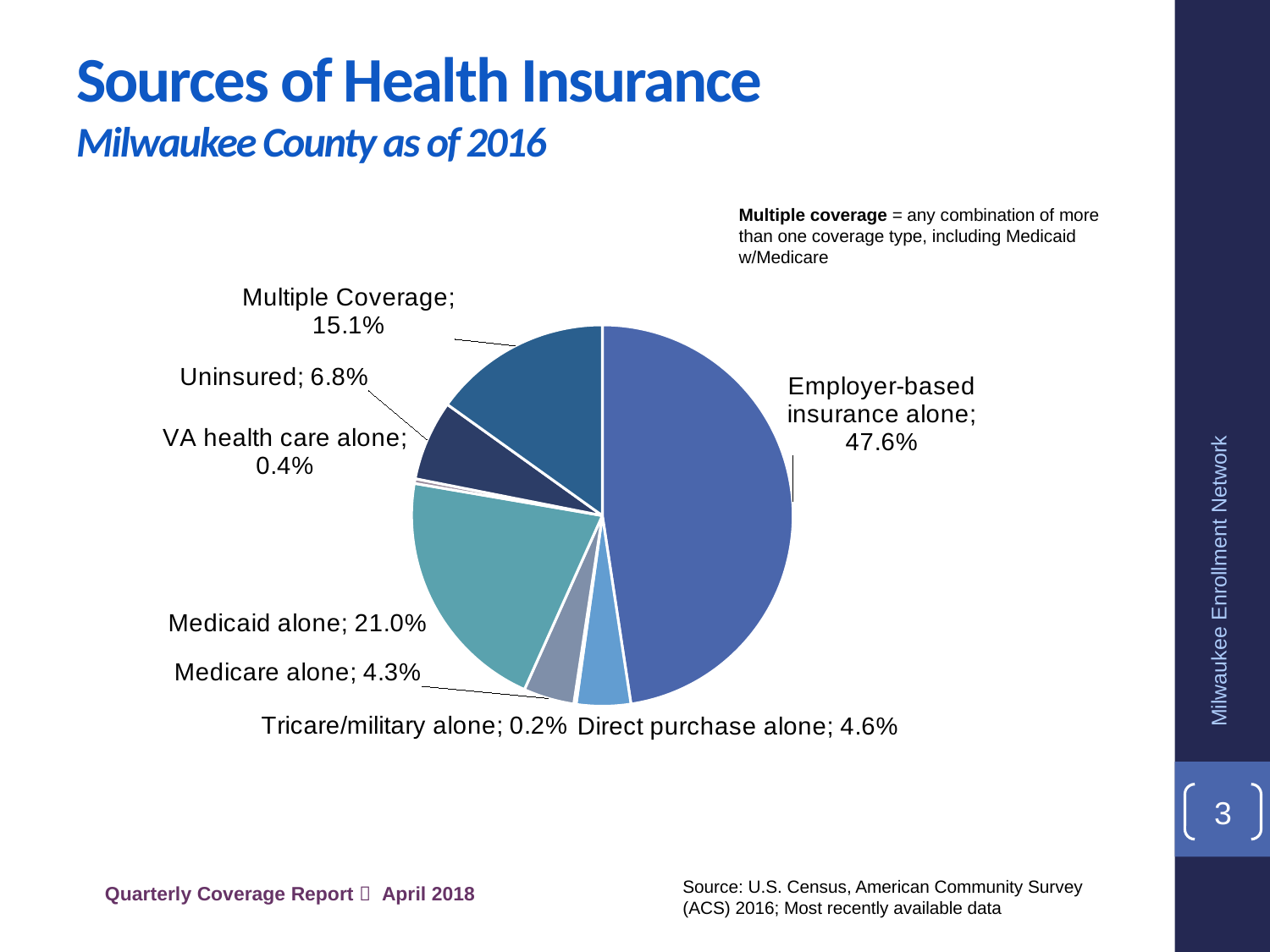
What is the value for Tricare/military alone? 0.2% Which is larger, Direct purchase alone or Medicare alone? Direct purchase alone How many categories are shown in the pie chart? 8 Which category has the smallest slice of the pie? Tricare/military alone Which category has the largest slice of the pie? Employer-based insurance alone What share of the pie is Employer-based insurance alone? 47.6% What kind of chart is shown on the slide? pie chart What is the value for Uninsured? 6.8% What is the difference between Uninsured and VA health care alone? 6.4% What is the value for Multiple Coverage? 15.1% What is the value for Medicaid alone? 21.0% What is the difference between Medicaid alone and Multiple Coverage? 5.9%